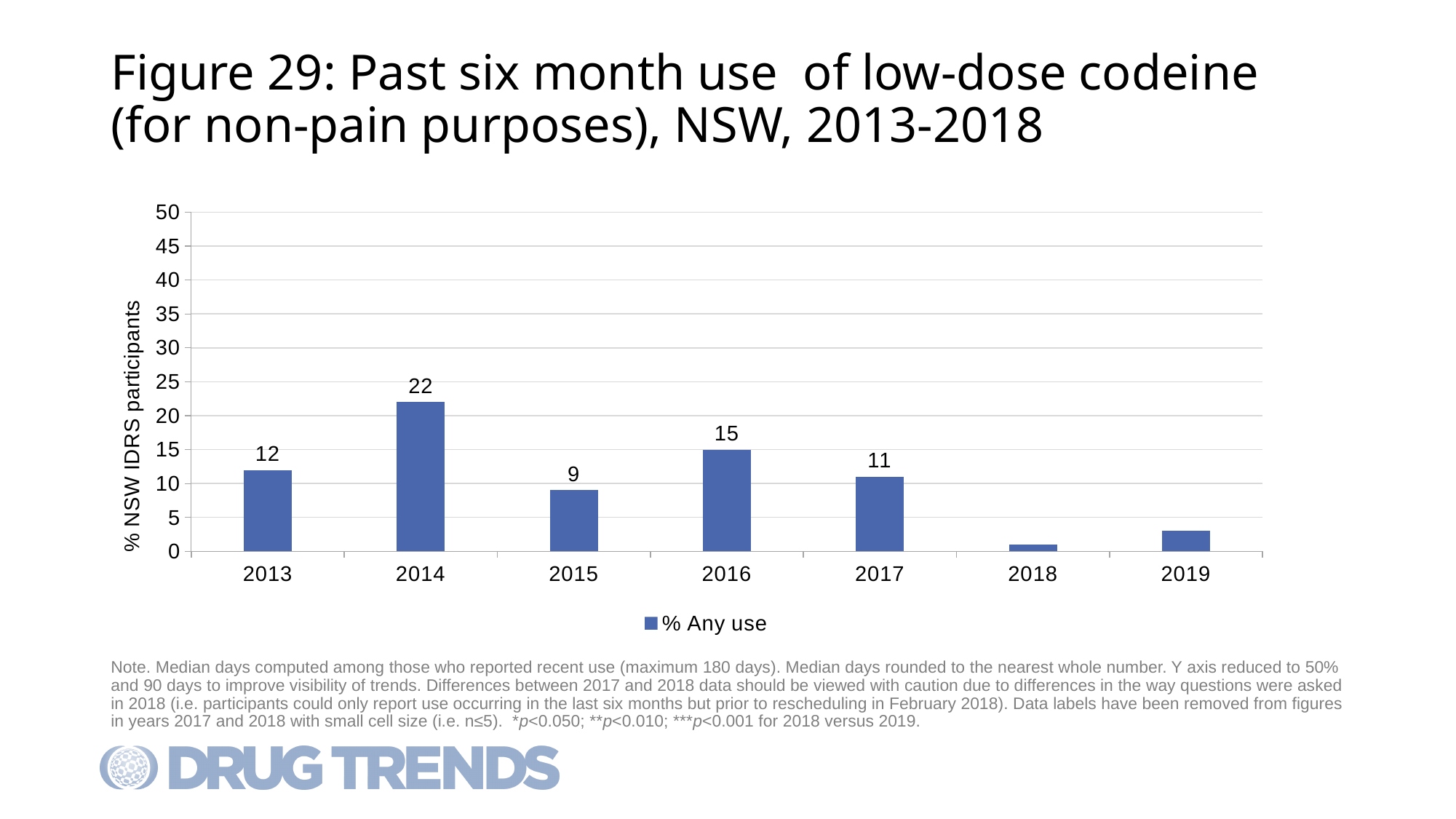
What is the value for 2016? 15 What is the value for 2015? 9 Which year has the lowest value? 2018 Is the value for 2018 greater or less than 5? less Which is larger, the value for 2016 or the value for 2017? 2016 What is the series name shown in the legend? % Any use Which year has the highest value? 2014 What is the difference between the values for 2014 and 2013? 10 What kind of chart is this? bar chart What is the value for 2014? 22 How many years are shown on the x axis? 7 Is the value for 2019 greater or less than 5? less